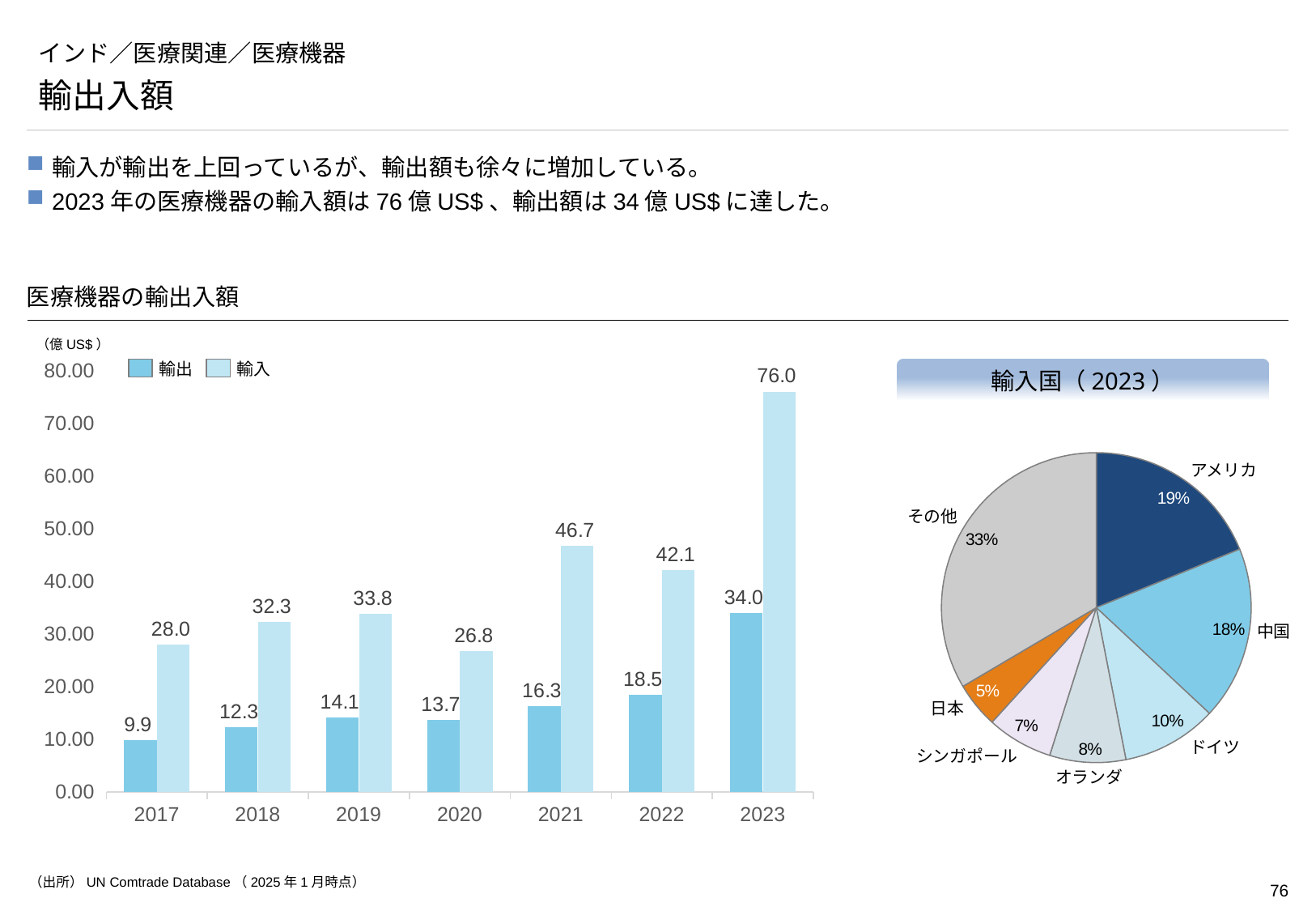
In the bar chart 医療機器の輸出入額, how many series does the legend list? 2 In the pie chart 輸入国（2023）, what share does 中国 have? 18% In the bar chart 医療機器の輸出入額, which year has the highest 輸出 value? 2023 In the bar chart 医療機器の輸出入額, how many years are shown on the x axis? 7 In the bar chart 医療機器の輸出入額, what is the value of 輸入 for 2023? 76.0 In the bar chart 医療機器の輸出入額, what is the value of 輸出 for 2017? 9.9 What kind of chart is 医療機器の輸出入額? bar chart In the bar chart 医療機器の輸出入額, which year has the lowest 輸入 value? 2020 In the bar chart 医療機器の輸出入額, which is larger in 2021: 輸出 or 輸入? 輸入 In the bar chart 医療機器の輸出入額, what is the difference between 輸入 and 輸出 in 2023? 42.0 In the pie chart 輸入国（2023）, how many slices are there? 7 In the pie chart 輸入国（2023）, which country has the smallest share? 日本